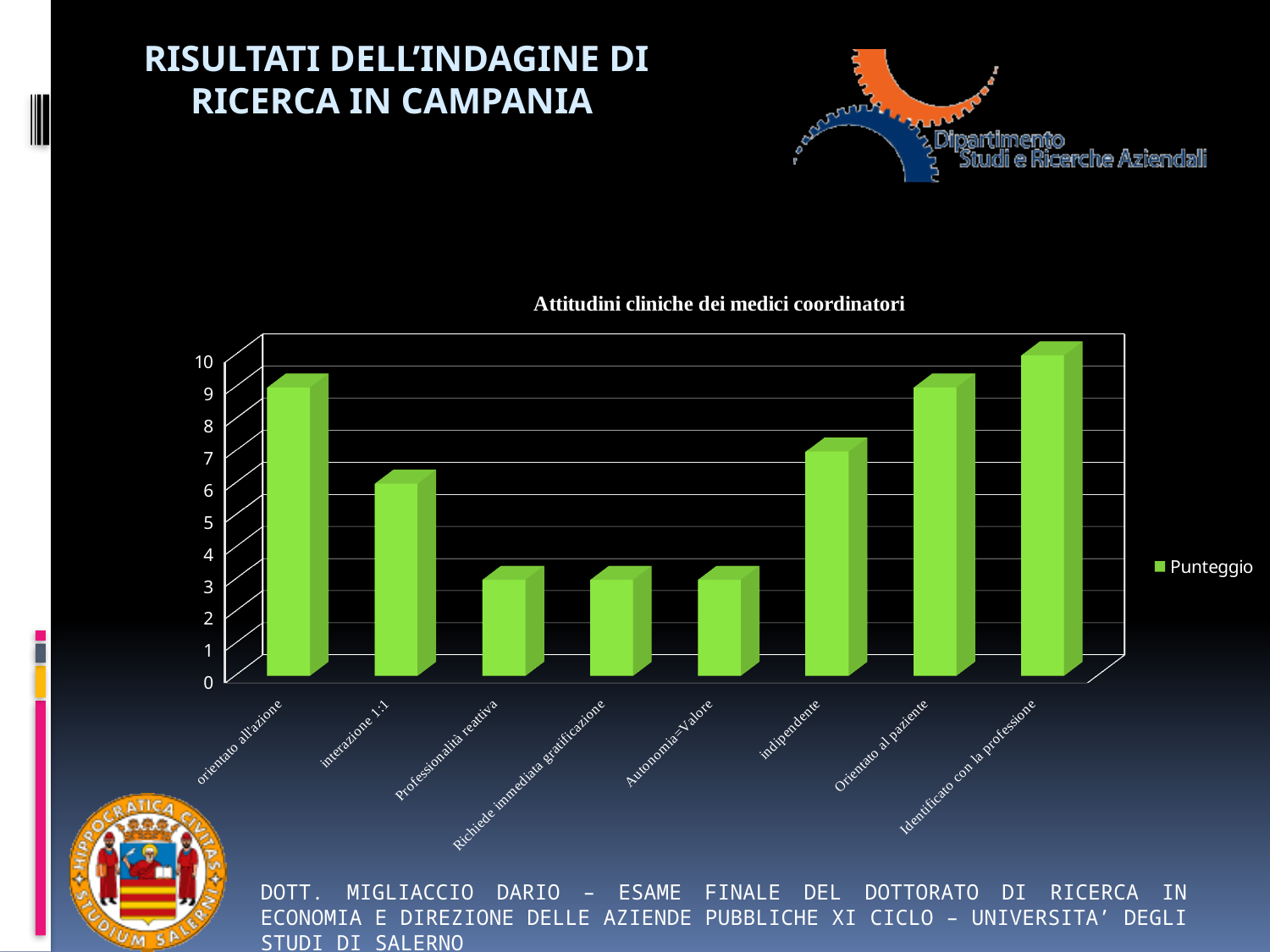
Is the value for indipendente greater or less than 5? greater Which is larger, the value for interazione 1:1 or the value for Professionalità reattiva? interazione 1:1 What kind of chart is shown on the slide? bar chart Which category has the highest Punteggio? Identificato con la professione Is the value for Professionalità reattiva greater or less than 5? less How many categories are plotted on the x axis? 8 What is the name of the series shown in the legend? Punteggio Is the value for Identificato con la professione greater or less than 8? greater Which is larger, the value for orientato all'azione or the value for interazione 1:1? orientato all'azione How many series does the legend list? 1 What is the title of the chart? Attitudini cliniche dei medici coordinatori